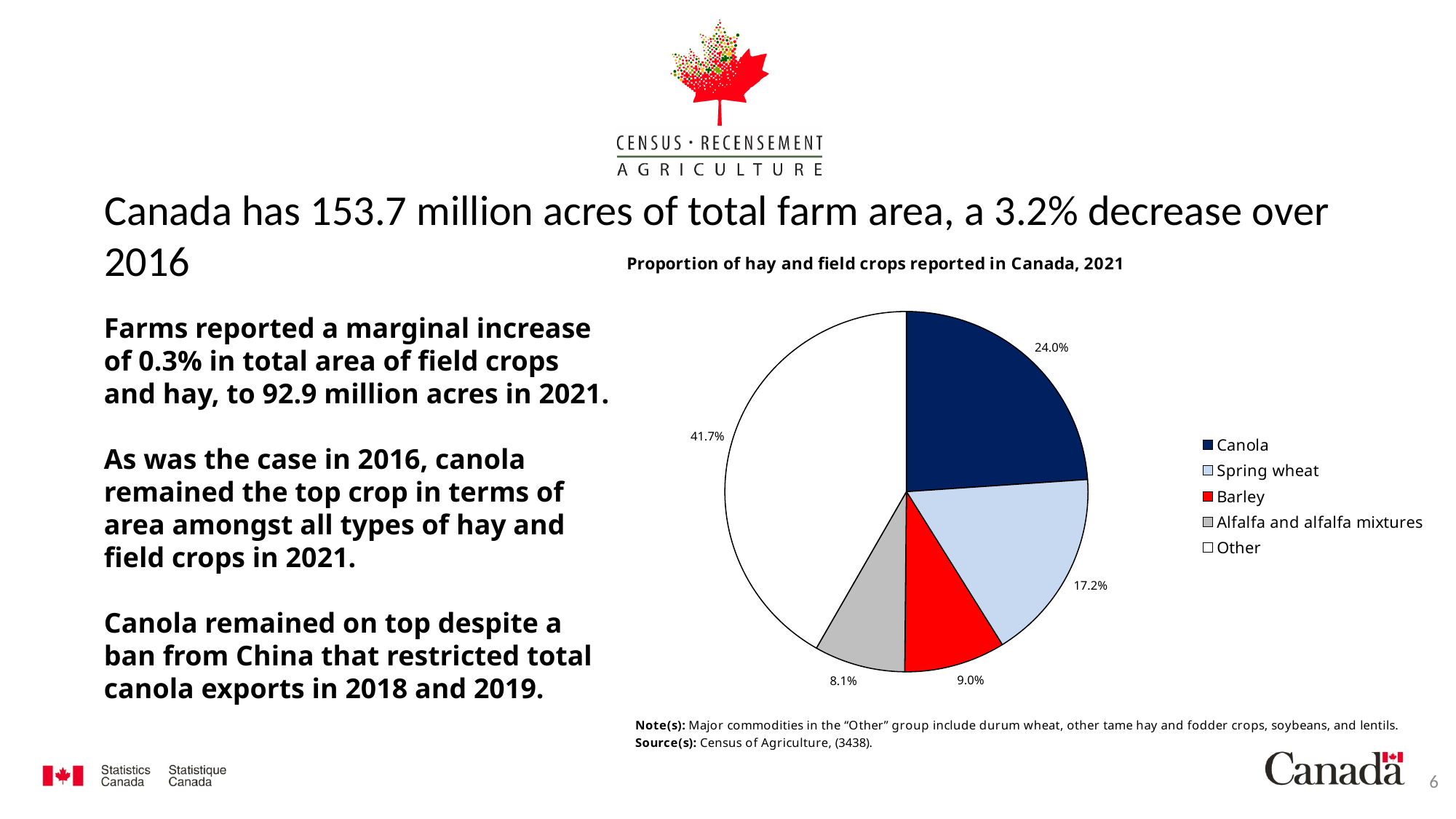
What share of the pie does Alfalfa and alfalfa mixtures represent? 8.1% What share of the pie does Canola represent? 24.0% How many categories does the legend list? 5 What share of the pie does Other represent? 41.7% Which category has the largest slice of the pie? Other Which category has the smallest slice of the pie? Alfalfa and alfalfa mixtures What is the difference in percentage points between Canola and Spring wheat? 6.8 Which is larger, the share for Barley or the share for Alfalfa and alfalfa mixtures? Barley What is the title of the chart? Proportion of hay and field crops reported in Canada, 2021 What type of chart is shown on the slide? pie chart